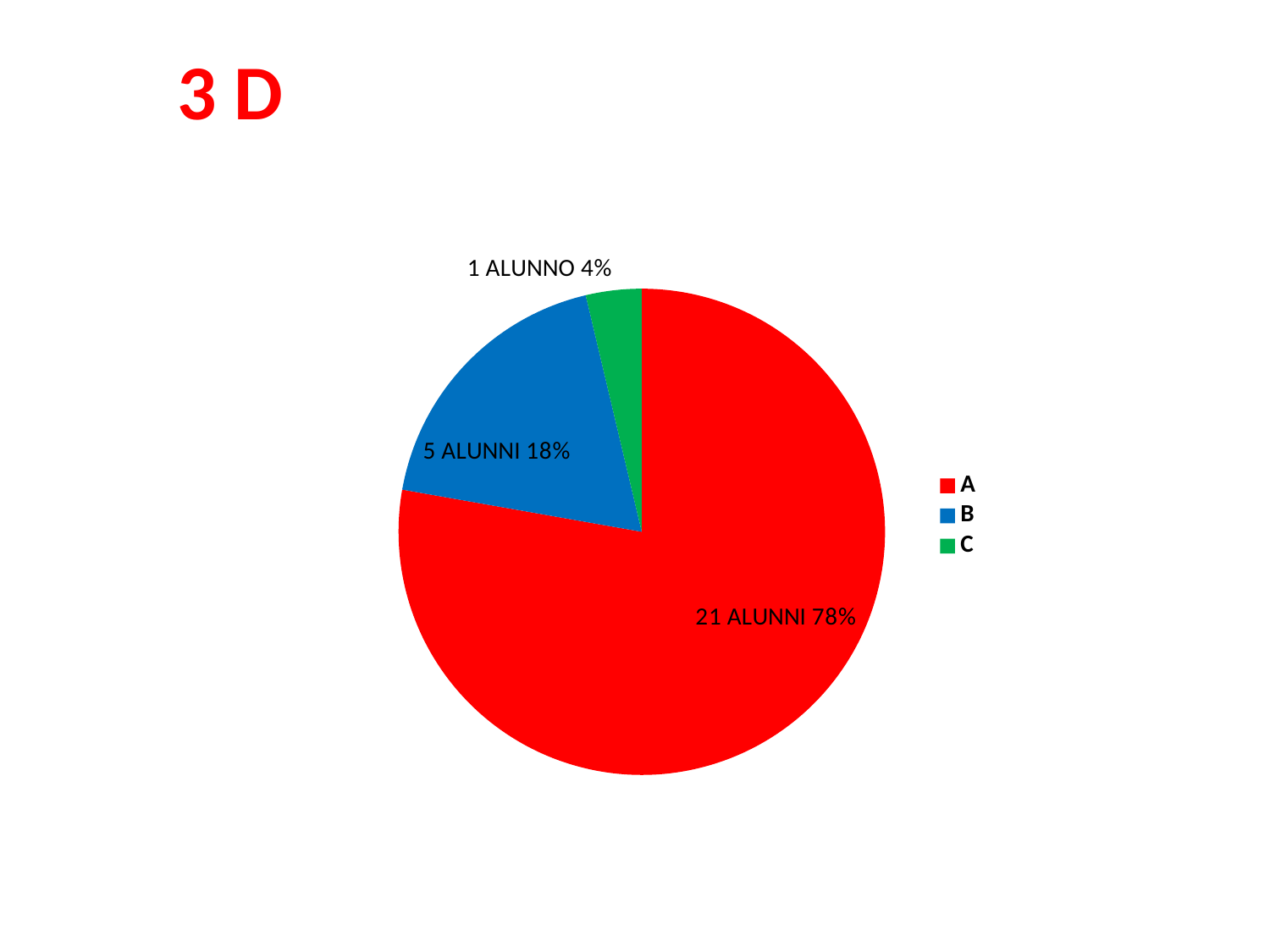
What share of the pie does category C have? 4% Which category has the largest slice of the pie? A What colour is the slice for category B? blue How many slices does the pie chart have? 3 How many students (alunni) are in category B? 5 What is the difference in number of students between category A and category B? 16 Which category has the smallest slice of the pie? C How many students are in category C? 1 What kind of chart is shown on the slide? pie chart What share of the pie does category A have? 78% What share of the pie does category B have? 18% How many students (alunni) are in category A? 21